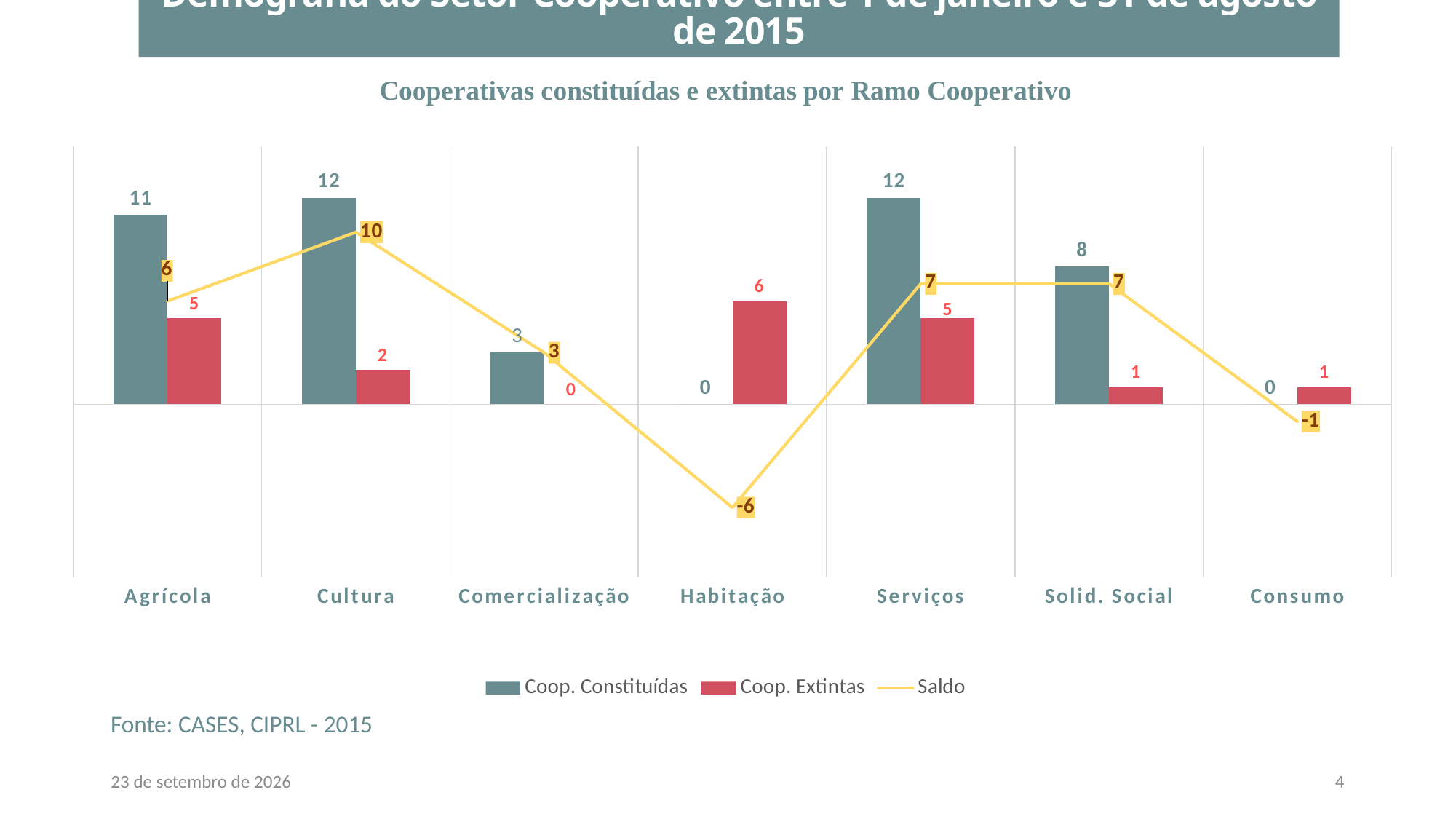
Which is larger for Serviços: Coop. Constituídas or Coop. Extintas? Coop. Constituídas Which category has the lowest Saldo value? Habitação How many categories are shown on the x axis? 7 Which series is drawn as a line rather than bars? Saldo Which category has the highest Coop. Extintas value? Habitação What is the Saldo value for Cultura? 10 What is the value of Coop. Extintas for Habitação? 6 What is the Saldo value for Consumo? -1 What is the title of the chart? Cooperativas constituídas e extintas por Ramo Cooperativo What is the value of Coop. Constituídas for Agrícola? 11 How many series does the legend list? 3 What is the difference between Coop. Constituídas and Coop. Extintas for Solid. Social? 7